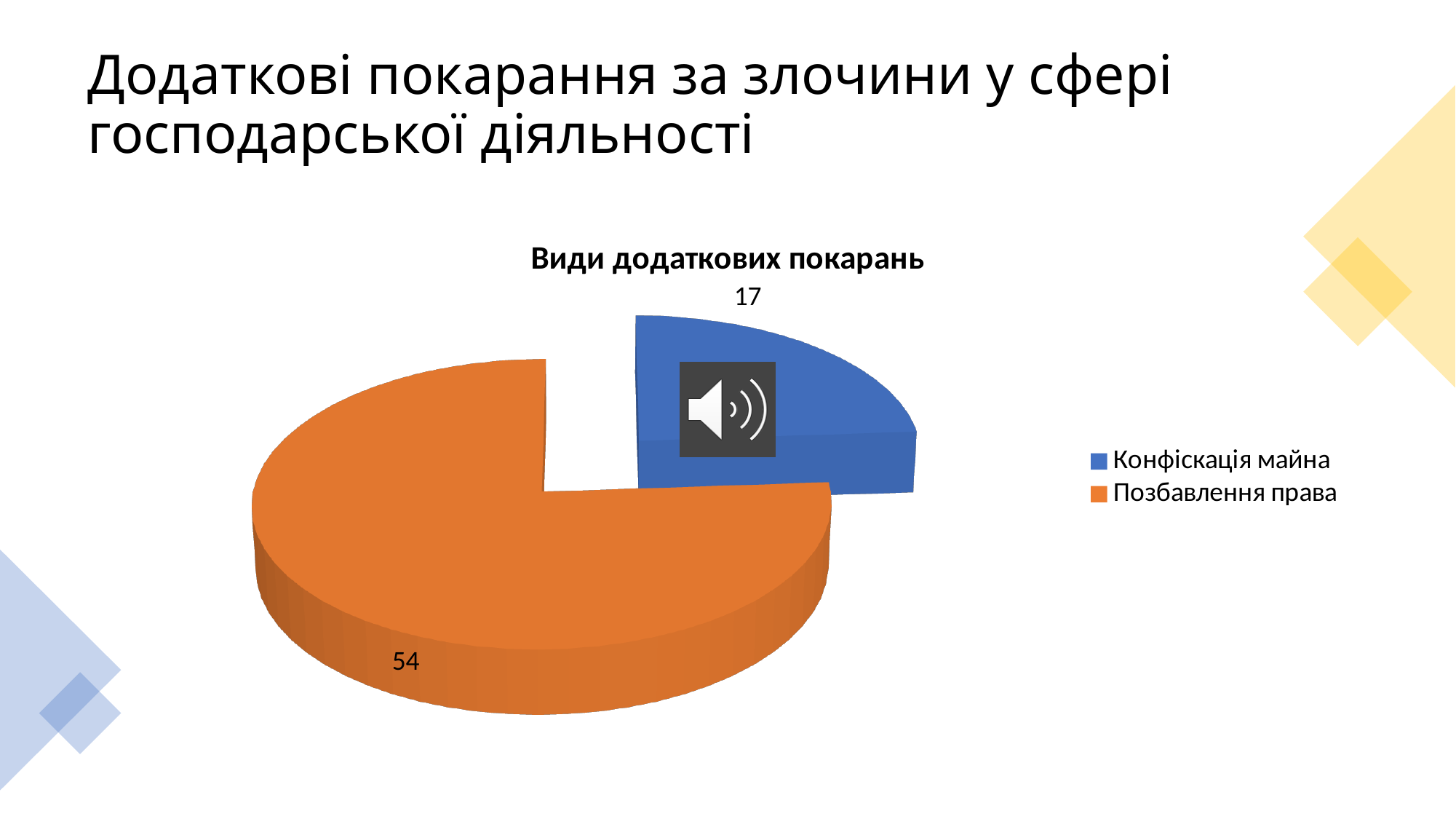
What is the value for Конфіскація майна? 17 Which category has the smallest slice of the pie? Конфіскація майна What share of the total does Позбавлення права represent? 54 out of 71 Which category has the largest slice of the pie? Позбавлення права Which is larger, the value for Конфіскація майна or the value for Позбавлення права? Позбавлення права What is the total of all slices in the pie chart? 71 What is the value for Позбавлення права? 54 How many categories does the pie chart have? 2 What type of chart is shown on the slide? pie chart What is the difference between the values for Позбавлення права and Конфіскація майна? 37 What is the title of the chart? Види додаткових покарань What colour is the slice for Конфіскація майна? blue